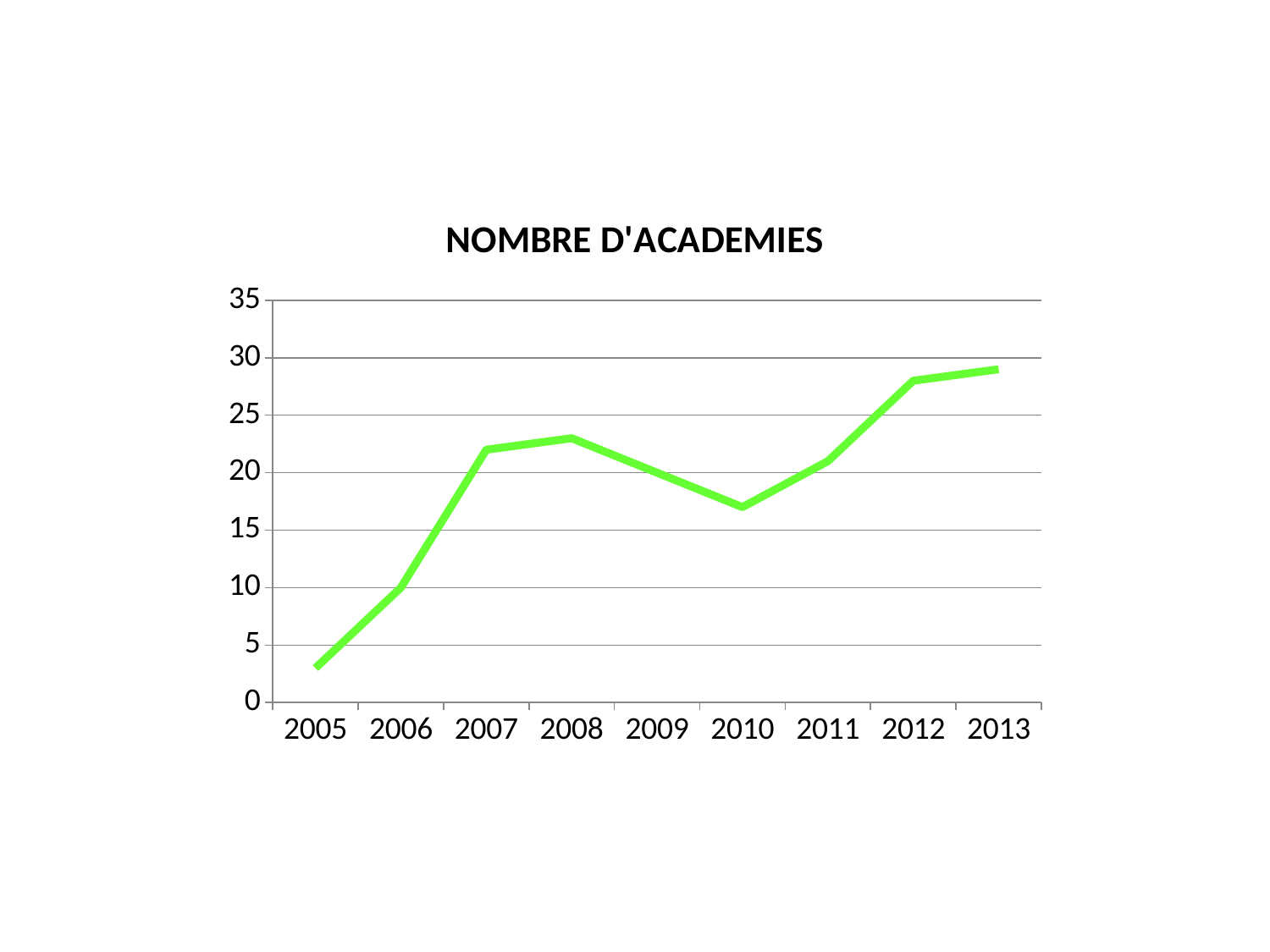
Is the value for 2005 greater or less than 5? less Is the value for 2007 greater or less than 20? greater Which is larger, the value for 2010 or the value for 2011? 2011 What is the title of the chart? NOMBRE D'ACADEMIES Is the value for 2010 greater or less than 20? less Do the values rise or fall from 2005 to 2008? rise What kind of chart is shown on the slide? line chart Do the values rise or fall from 2008 to 2010? fall Which year has the lowest value? 2005 How many years are plotted along the x axis? 9